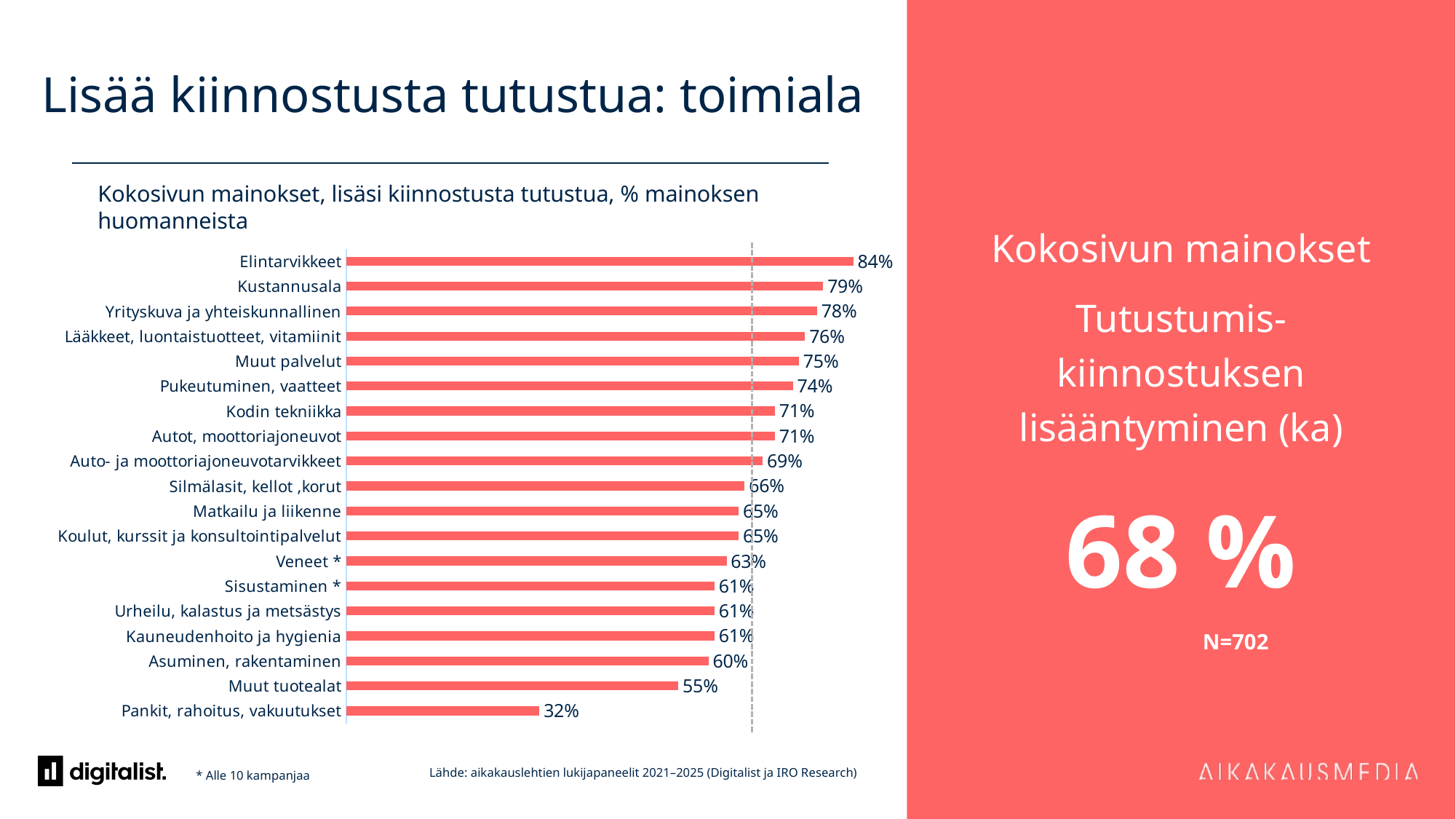
What is the difference between the values for Kustannusala and Muut tuotealat? 24% What is the value for Pankit, rahoitus, vakuutukset? 32% How many categories are shown in the chart? 19 What is the value for Kodin tekniikka? 71% Which category has the lowest value? Pankit, rahoitus, vakuutukset What is the value for Elintarvikkeet? 84% What is the value for Muut tuotealat? 55% What kind of chart is shown on the slide? Bar chart Which category has the highest value? Elintarvikkeet Which is larger, the value for Veneet * or the value for Asuminen, rakentaminen? Veneet * What is the difference between the values for Elintarvikkeet and Pankit, rahoitus, vakuutukset? 52% What average value is shown in the red panel on the right of the slide? 68 %